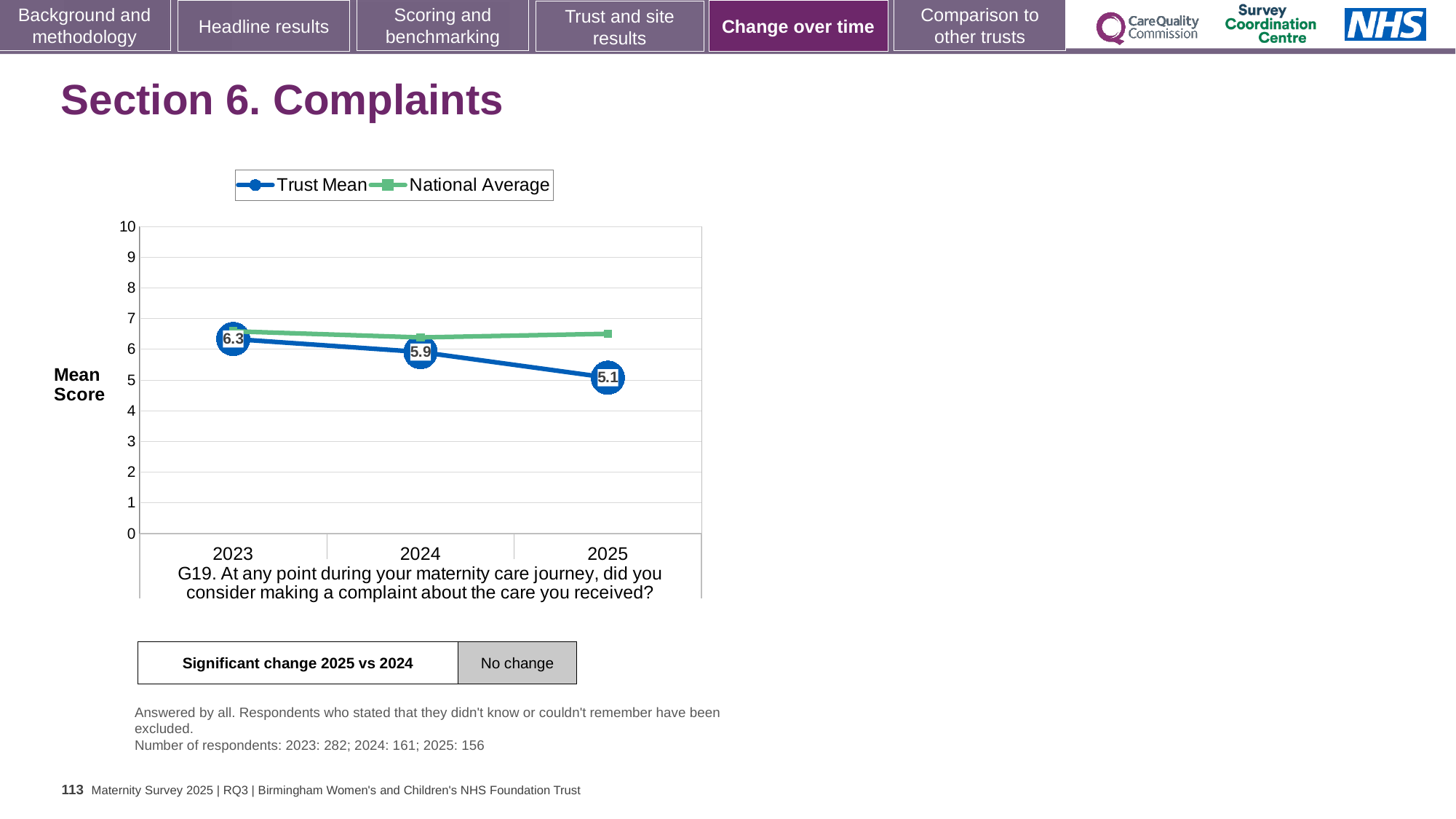
How many years are shown on the x axis? 3 What kind of chart is shown? line chart In which year is the Trust Mean lowest? 2025 What is the difference between the Trust Mean in 2023 and 2025? 1.2 In which year is the Trust Mean highest? 2023 What is the Trust Mean score for 2024? 5.9 What is the Trust Mean score for 2025? 5.1 Which is larger, the Trust Mean in 2024 or in 2025? 2024 Is the National Average for 2025 greater or less than 6? greater What is the Trust Mean score for 2023? 6.3 Does the Trust Mean rise or fall from 2023 to 2025? fall How many series does the legend list? 2